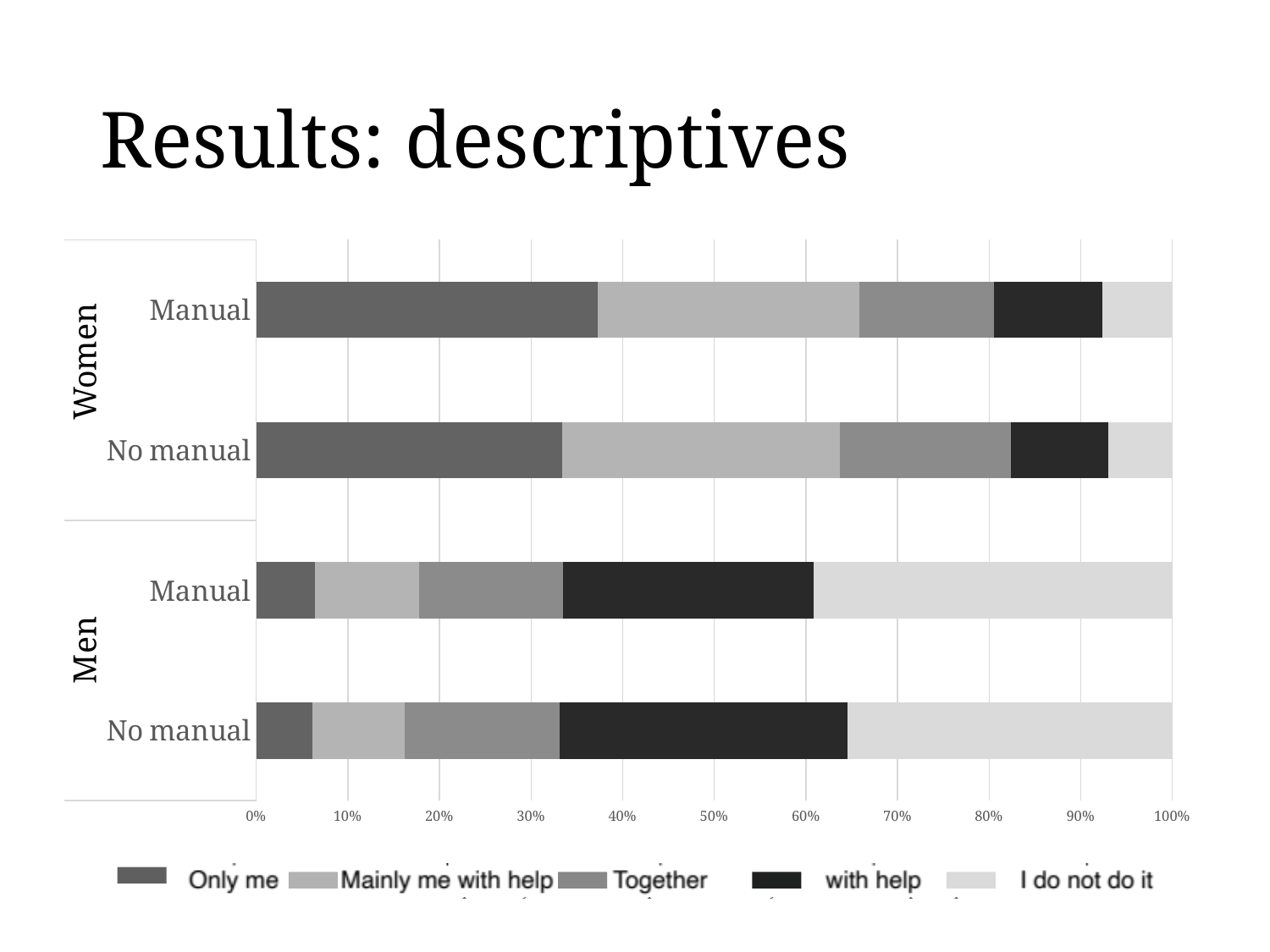
Is the 'Only me' share for Men Manual greater or less than 10%? less How many bars (category rows) does the chart show? 4 What kind of chart is shown on the slide? Stacked bar chart What is the title of the slide containing the chart? Results: descriptives Is the 'I do not do it' share for Men Manual greater or less than 30%? greater How many series does the legend list? 5 Which has a larger 'I do not do it' share: Men No manual or Women No manual? Men No manual Is the 'Only me' share for Women Manual greater or less than 30%? greater Which legend entry is shown in the darkest (black) colour? with help Which has a larger 'with help' share: Men Manual or Women Manual? Men Manual Which has a larger 'Only me' share: Women Manual or Men Manual? Women Manual